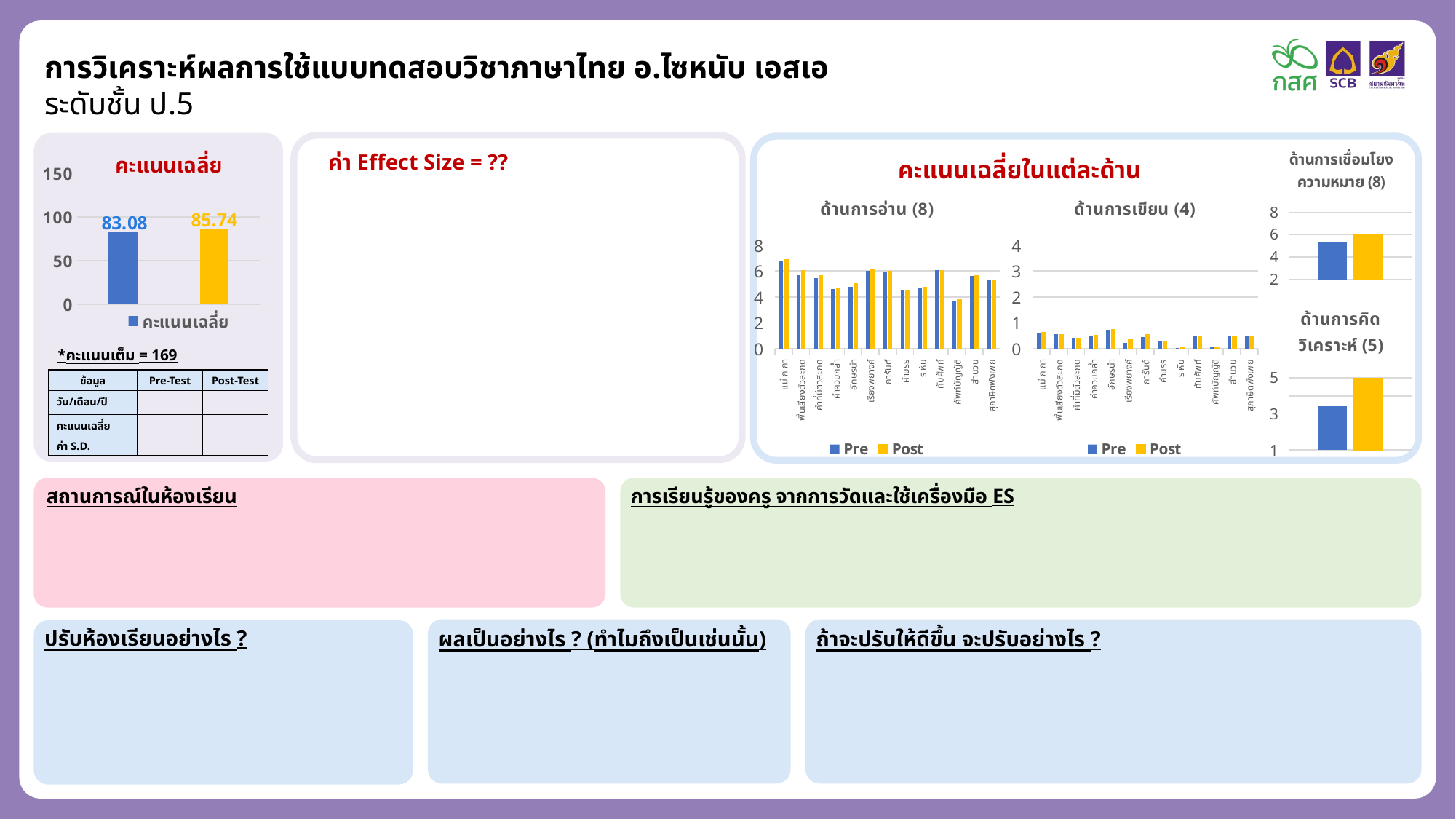
In the ด้านการคิดวิเคราะห์ (5) chart, which bar is higher, the blue (Pre) bar or the yellow (Post) bar? the yellow (Post) bar In the คะแนนเฉลี่ย chart on the left, what value is shown on the yellow bar? 85.74 In the ด้านการคิดวิเคราะห์ (5) chart, is the value of the blue (Pre) bar greater or less than 3? greater In the คะแนนเฉลี่ย chart on the left, is the value of the blue bar greater or less than 100? less In the คะแนนเฉลี่ย chart on the left, what is the difference between the yellow bar and the blue bar? 2.66 What kind of chart is the คะแนนเฉลี่ย chart on the left? bar chart In the คะแนนเฉลี่ย chart on the left, which bar is higher, the blue one or the yellow one? the yellow bar (85.74) In the ด้านการเชื่อมโยงความหมาย (8) chart, is the value of the blue (Pre) bar greater or less than 4? greater In the คะแนนเฉลี่ย chart on the left, what value is shown on the blue bar? 83.08 In the คะแนนเฉลี่ย chart on the left, how many bars are plotted? 2 What is the title of the chart panel on the right side of the slide? คะแนนเฉลี่ยในแต่ละด้าน In the ด้านการอ่าน (8) chart, how many series does the legend list? 2